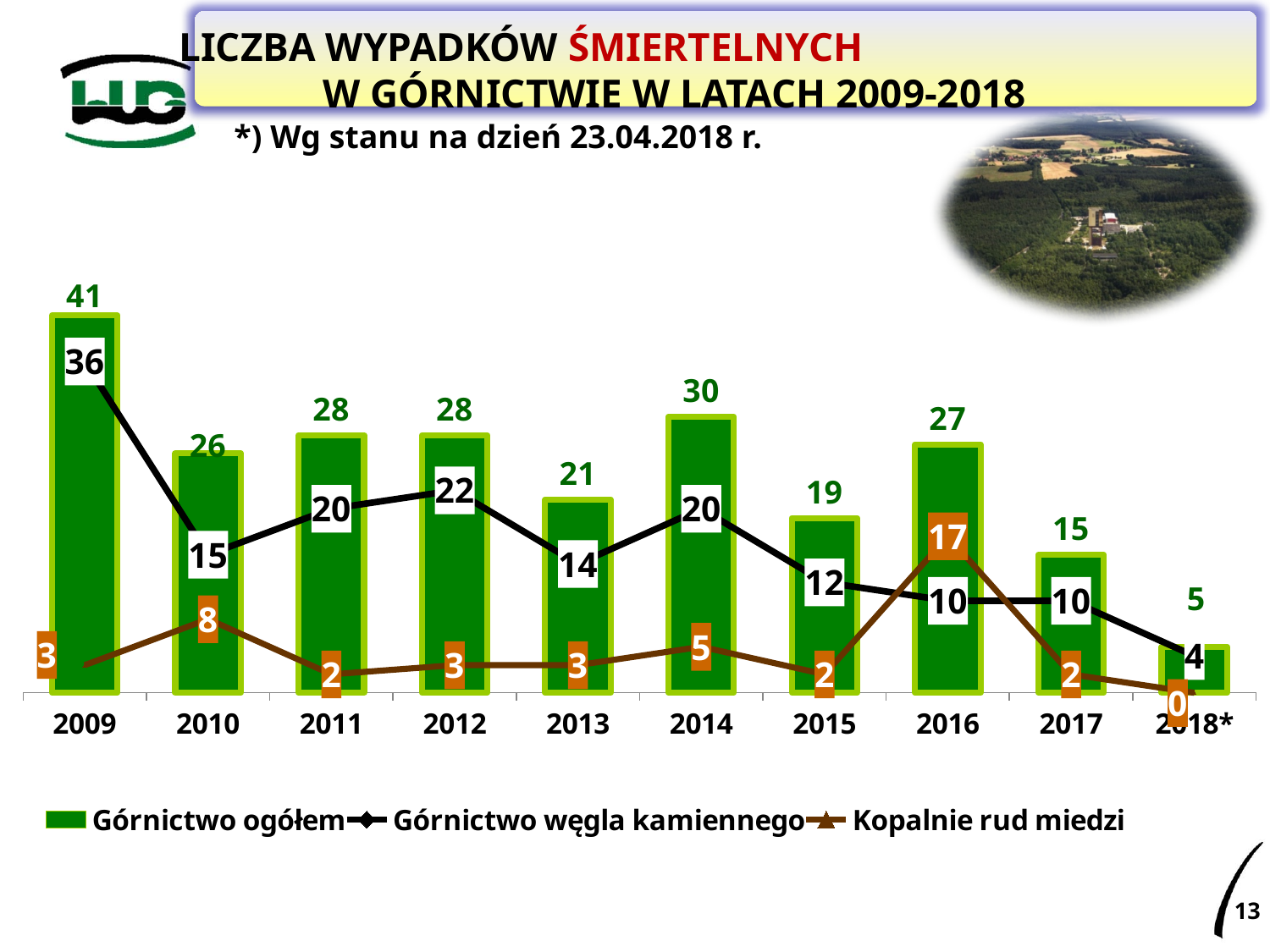
What is the value of Kopalnie rud miedzi for 2016? 17 What is the value of Górnictwo węgla kamiennego for 2012? 22 What kind of chart is used for the Górnictwo ogółem series? bar chart Which year has the lowest value for Kopalnie rud miedzi? 2018* What is the value of Górnictwo ogółem for 2009? 41 What is the difference between Górnictwo ogółem in 2014 and in 2015? 11 Do the values for Górnictwo węgla kamiennego rise or fall from 2016 to 2018*? fall How many series does the legend list? 3 Which year has the highest value for Górnictwo ogółem? 2009 Which is larger: Górnictwo węgla kamiennego in 2010 or in 2011? 2011 How many years are shown on the x axis? 10 Which series is shown with a brown line and triangle markers? Kopalnie rud miedzi